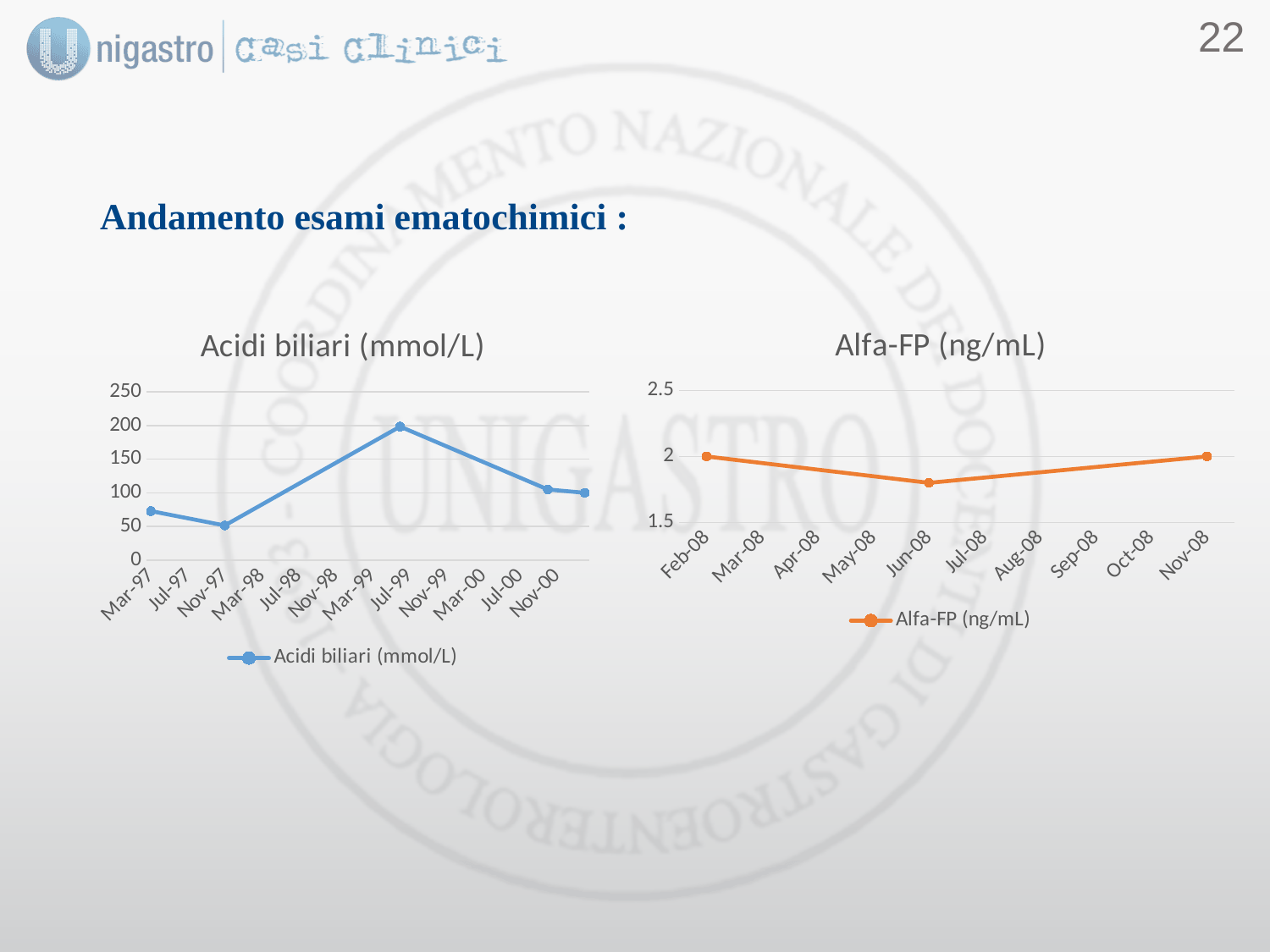
What colour is the line in the 'Alfa-FP (ng/mL)' chart? orange In the 'Acidi biliari (mmol/L)' chart, is the value for Mar-97 greater or less than 100? less In the 'Alfa-FP (ng/mL)' chart, is the value for Jun-08 greater or less than 2? less In the 'Alfa-FP (ng/mL)' chart, at which date is the value lowest? Jun-08 How many data points are plotted in the 'Alfa-FP (ng/mL)' chart? 3 In the 'Alfa-FP (ng/mL)' chart, what is the value for Feb-08? 2 In the 'Acidi biliari (mmol/L)' chart, at which date is the value lowest? Nov-97 How many series does the legend of the 'Acidi biliari (mmol/L)' chart list? 1 What type of chart is the 'Acidi biliari (mmol/L)' chart? line chart